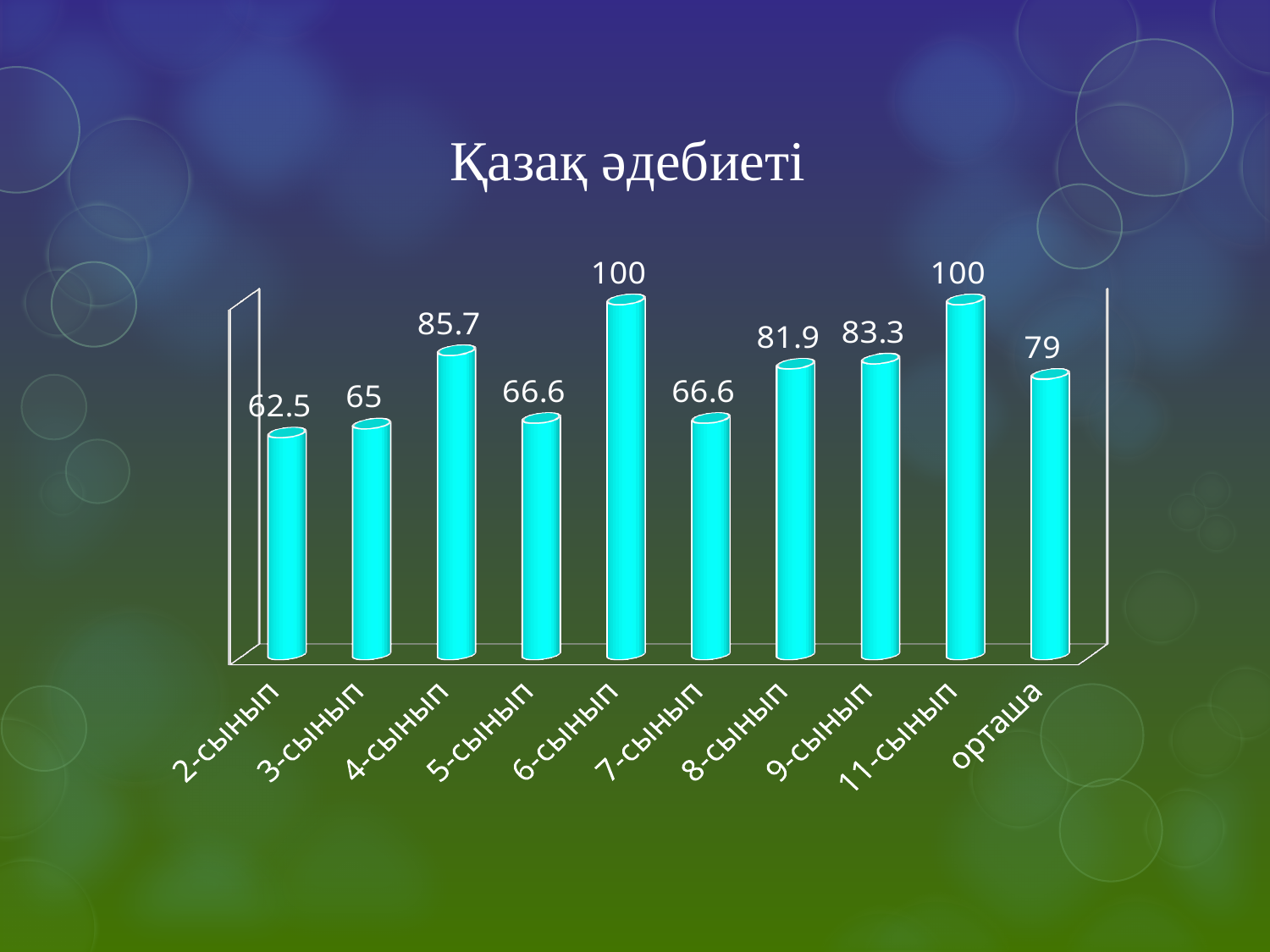
What is the value for 8-сынып? 81.9 Which category has the lowest value? 2-сынып What is the difference between the values for 9-сынып and 8-сынып? 1.4 Which is larger, the value for 4-сынып or the value for 9-сынып? 4-сынып What is the value for 4-сынып? 85.7 What kind of chart is shown on the slide? Bar chart What is the value for 2-сынып? 62.5 How many categories are shown on the x axis? 10 What is the value for орташа? 79 What is the title of the chart? Қазақ әдебиеті Which two categories share the highest value of 100? 6-сынып and 11-сынып What is the difference between the values for 6-сынып and 2-сынып? 37.5